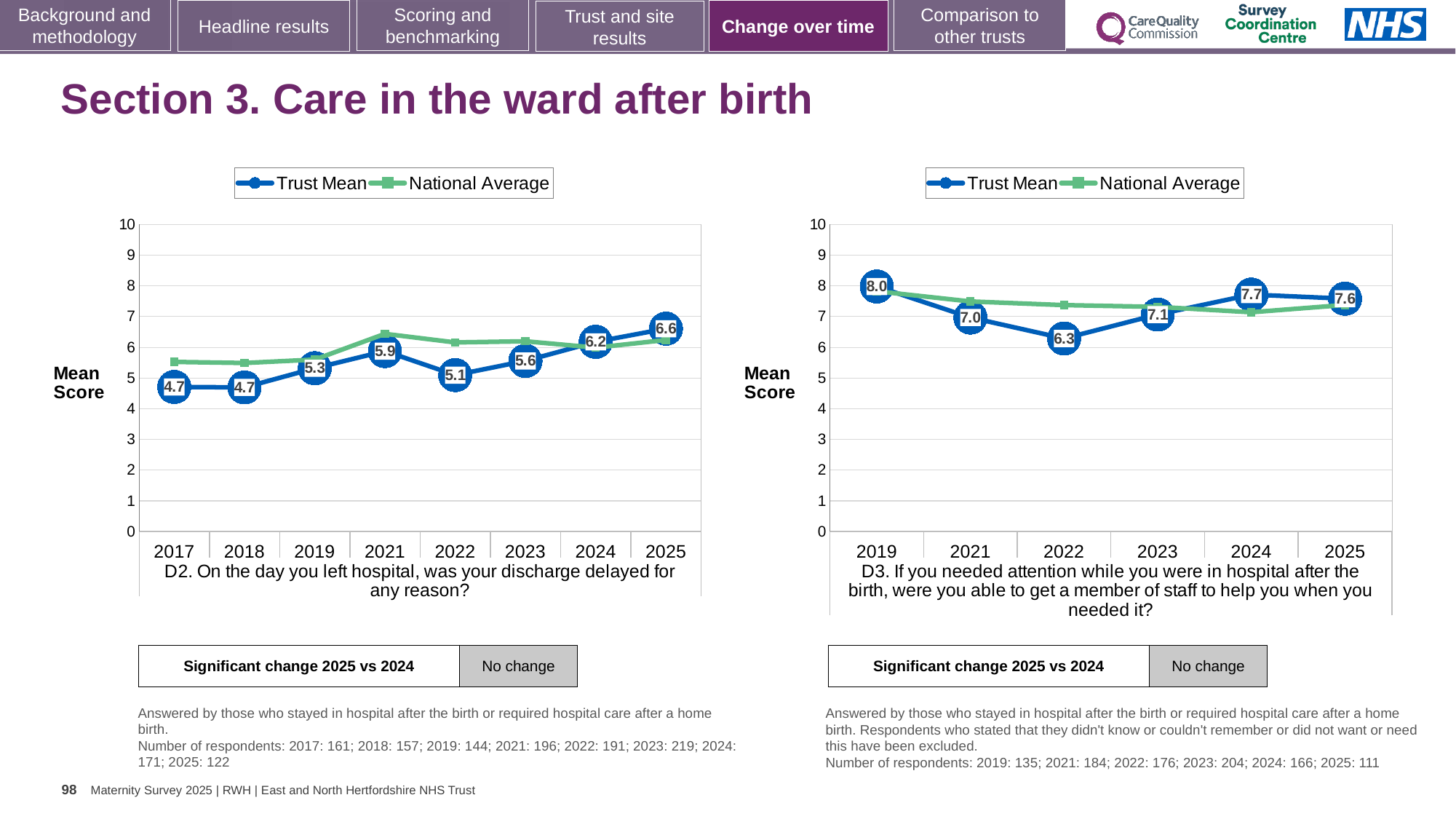
In the right chart (D3), is the National Average value for 2019 greater or less than 7? greater How many years are plotted on the x axis of the left chart (D2)? 8 How many series does the legend of the right chart (D3) list? 2 In the left chart (D2), is the National Average value for 2021 greater or less than 6? greater In the right chart (D3), which year has the lowest Trust Mean score? 2022 In the left chart (D2), what is the Trust Mean score for 2025? 6.6 In the right chart (D3), which is larger, the Trust Mean score for 2019 or for 2024? 2019 In the left chart (D2), what is the difference between the Trust Mean scores for 2025 and 2017? 1.9 In the right chart (D3), what is the Trust Mean score for 2022? 6.3 In the left chart (D2), which year has the highest Trust Mean score? 2025 In the left chart (D2), does the Trust Mean rise or fall from 2022 to 2025? Rise What kind of chart is the left chart (D2)? Line chart